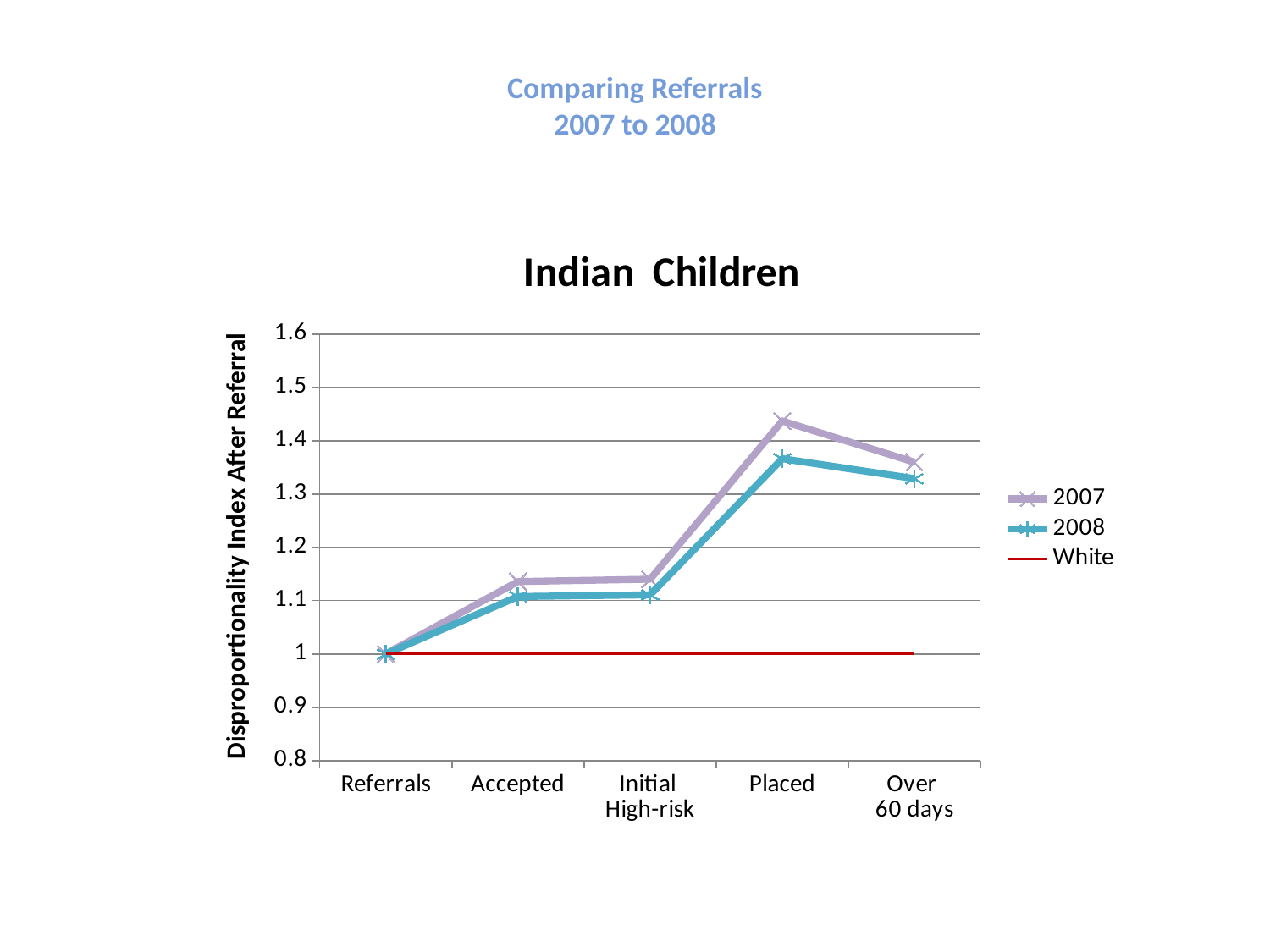
For which category is the 2008 series lowest? Referrals Is the 2008 value for Placed greater or less than 1.4? less What is the label of the y axis? Disproportionality Index After Referral What kind of chart is shown on the slide? line chart Is the 2008 value for Over 60 days greater or less than 1.3? greater How many categories are shown on the x axis? 5 Do the 2008 values rise or fall from Referrals to Placed? rise Is the 2007 value for Placed greater or less than 1.4? greater For which category is the 2007 series highest? Placed At Placed, which series is larger, 2007 or 2008? 2007 What is the title of the chart? Indian Children How many series does the legend list? 3